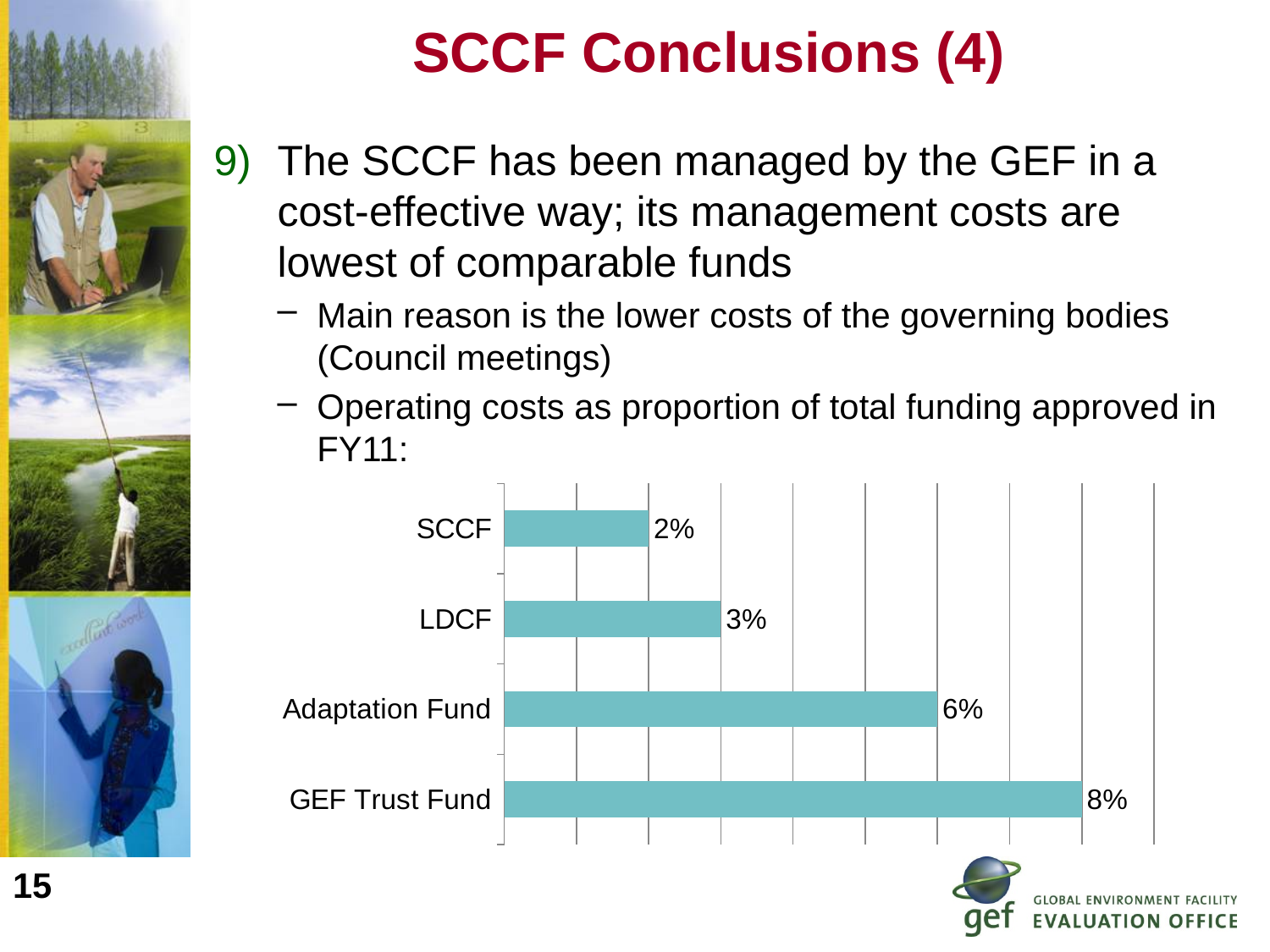
What is the value for Adaptation Fund? 6% What kind of chart is shown on the slide? Bar chart Which is larger, the value for LDCF or the value for Adaptation Fund? Adaptation Fund What is the value for SCCF? 2% What is the value for GEF Trust Fund? 8% What is the difference between the GEF Trust Fund and SCCF values? 6% Which fund has the highest operating cost proportion? GEF Trust Fund What is the difference between the Adaptation Fund and LDCF values? 3% How many funds are shown in the chart? 4 Which fund has the lowest operating cost proportion? SCCF What colour are the bars in the chart? Teal (light blue-green) What is the value for LDCF? 3%